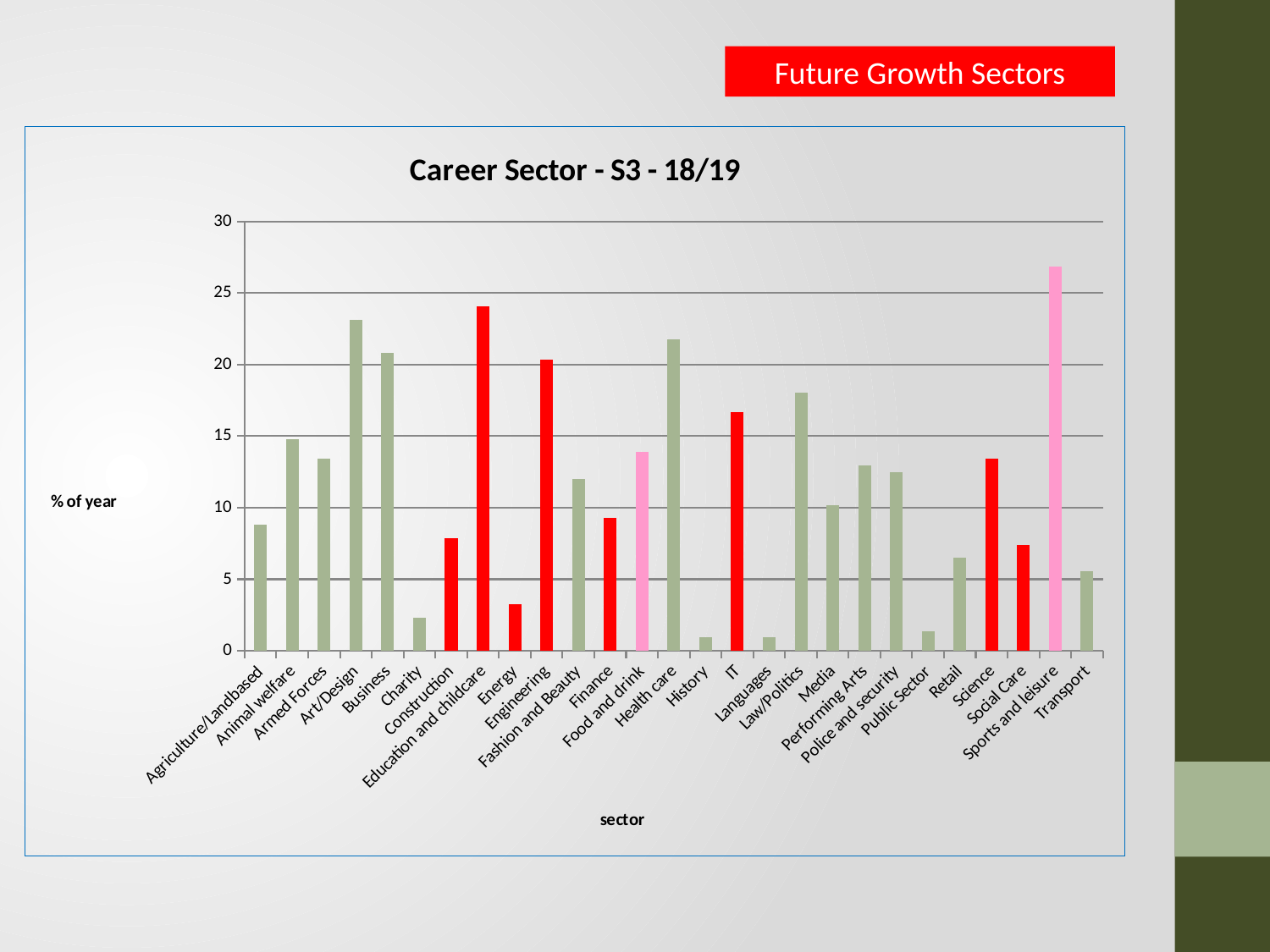
Is the value for Charity greater or less than 5? less Which has the larger value, Education and childcare or Engineering? Education and childcare Is the value for Finance greater or less than 10? less How many sectors are shown on the x axis of the chart? 27 What is the label on the vertical axis of the chart? % of year Is the value for IT greater or less than 15? greater What type of chart is shown on the slide? bar chart Which sector has the highest value in the chart? Sports and leisure Which has the larger value, Science or Social Care? Science What is the title of the chart? Career Sector - S3 - 18/19